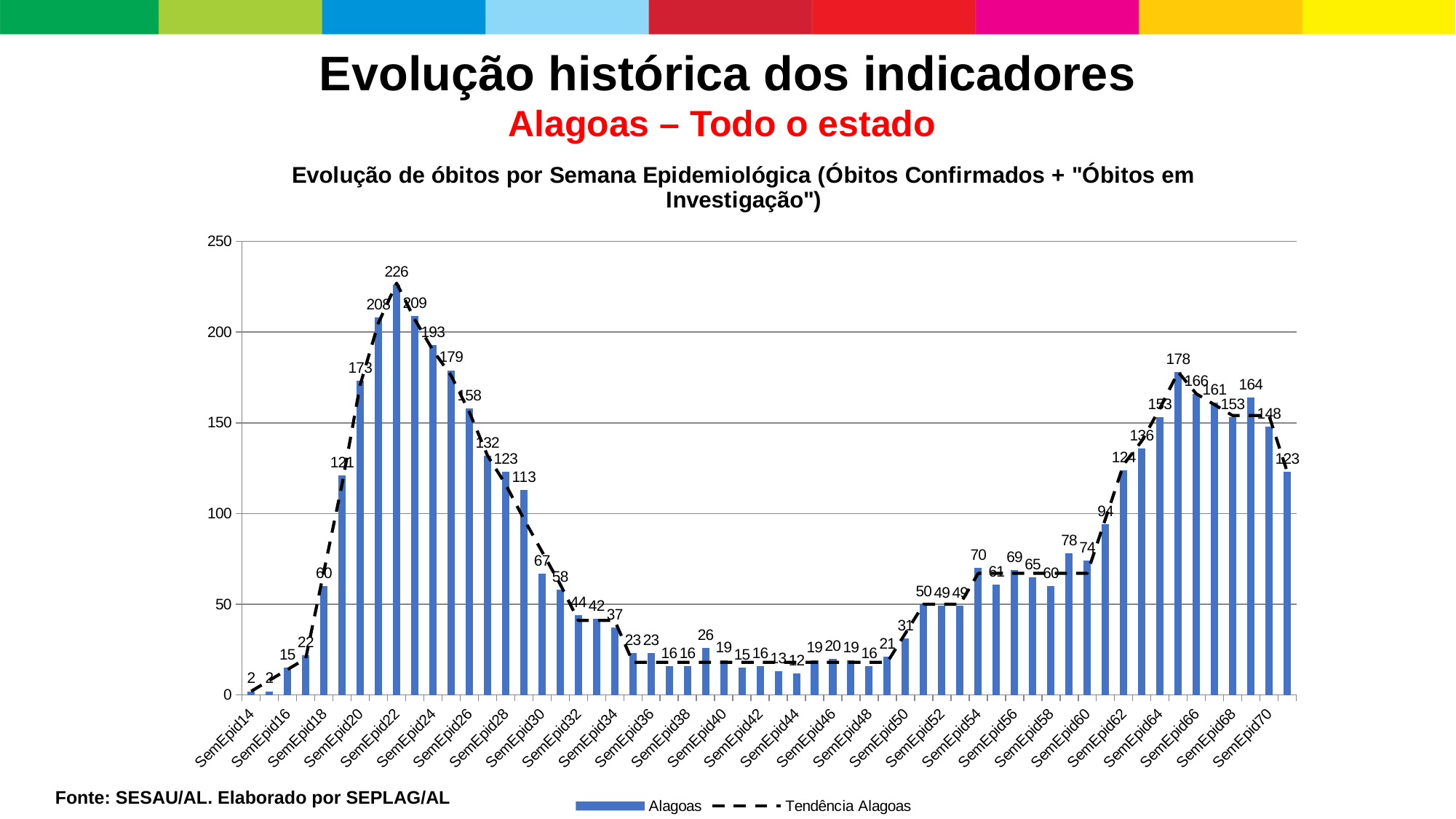
What is the value for SemEpid30? 67 What is the value for SemEpid70? 148 Which epidemiological week has the highest number of deaths? SemEpid22 What is the difference between the values for SemEpid22 and SemEpid20? 53 What type of chart is shown on the slide? Combination bar and line chart (bars with a dashed trend line) Which has a larger value, SemEpid20 or SemEpid24? SemEpid24 How many series does the legend list? 2 What is the value for SemEpid62? 124 What is the highest value shown in the chart? 226 Do the values rise or fall from SemEpid14 to SemEpid22? Rise What are the two legend entries? Alagoas and Tendência Alagoas What is the lowest value shown in the chart? 2